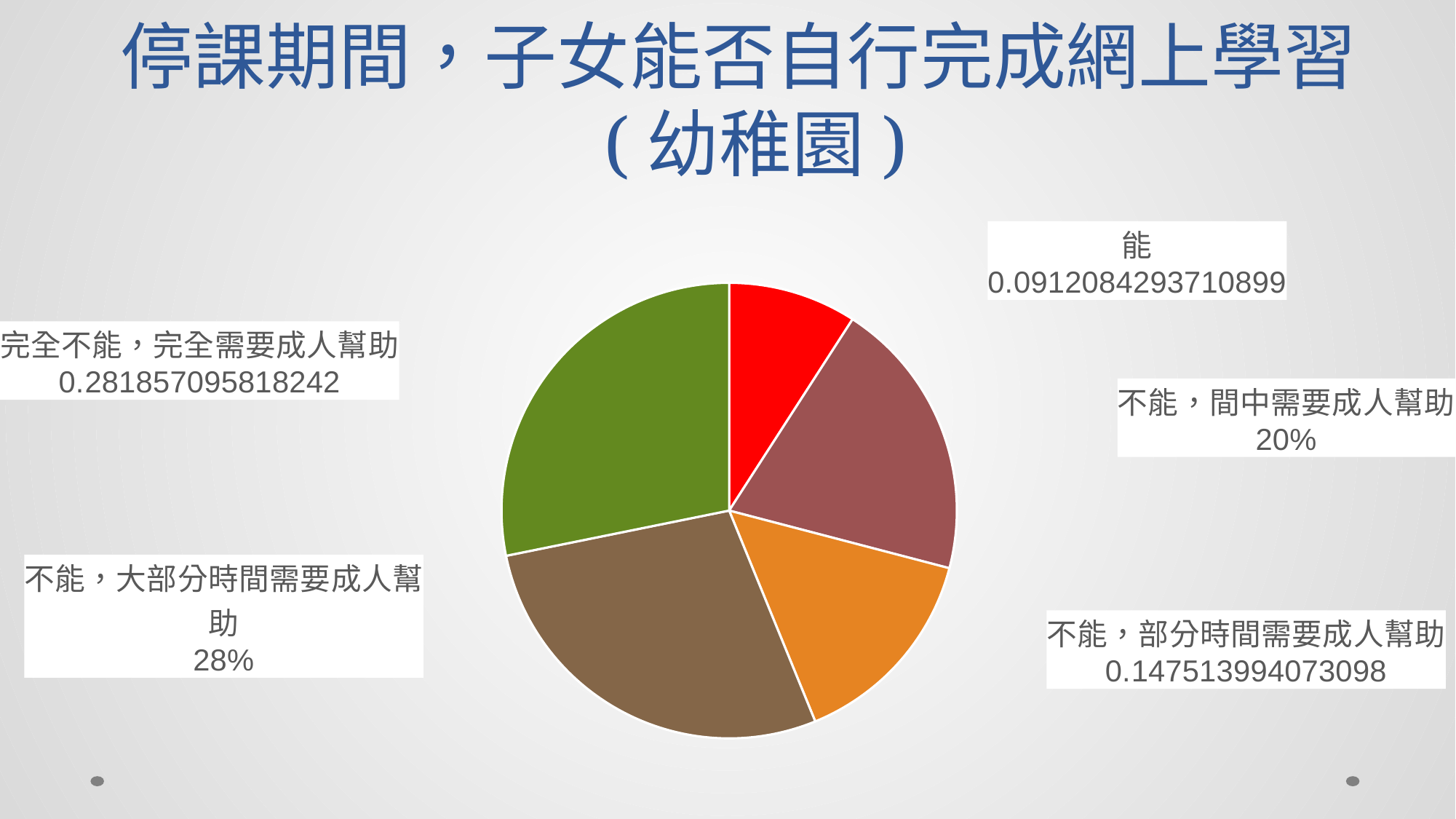
What is the value shown for the slice labelled 不能，大部分時間需要成人幫助? 28% What kind of chart is shown on the slide? pie chart What is the title of the slide containing the pie chart? 停課期間，子女能否自行完成網上學習（幼稚園） What is the value shown for the slice labelled 能? 0.0912084293710899 What is the value shown for the slice labelled 完全不能，完全需要成人幫助? 0.281857095818242 Which slice of the pie chart is the smallest? 能 What colour is the slice labelled 能? red What is the value shown for the slice labelled 不能，間中需要成人幫助? 20% How many slices does the pie chart have? 5 Which slice is larger: 能 or 不能，間中需要成人幫助? 不能，間中需要成人幫助 What is the value shown for the slice labelled 不能，部分時間需要成人幫助? 0.147513994073098 Which slice is larger: 不能，部分時間需要成人幫助 or 不能，大部分時間需要成人幫助? 不能，大部分時間需要成人幫助